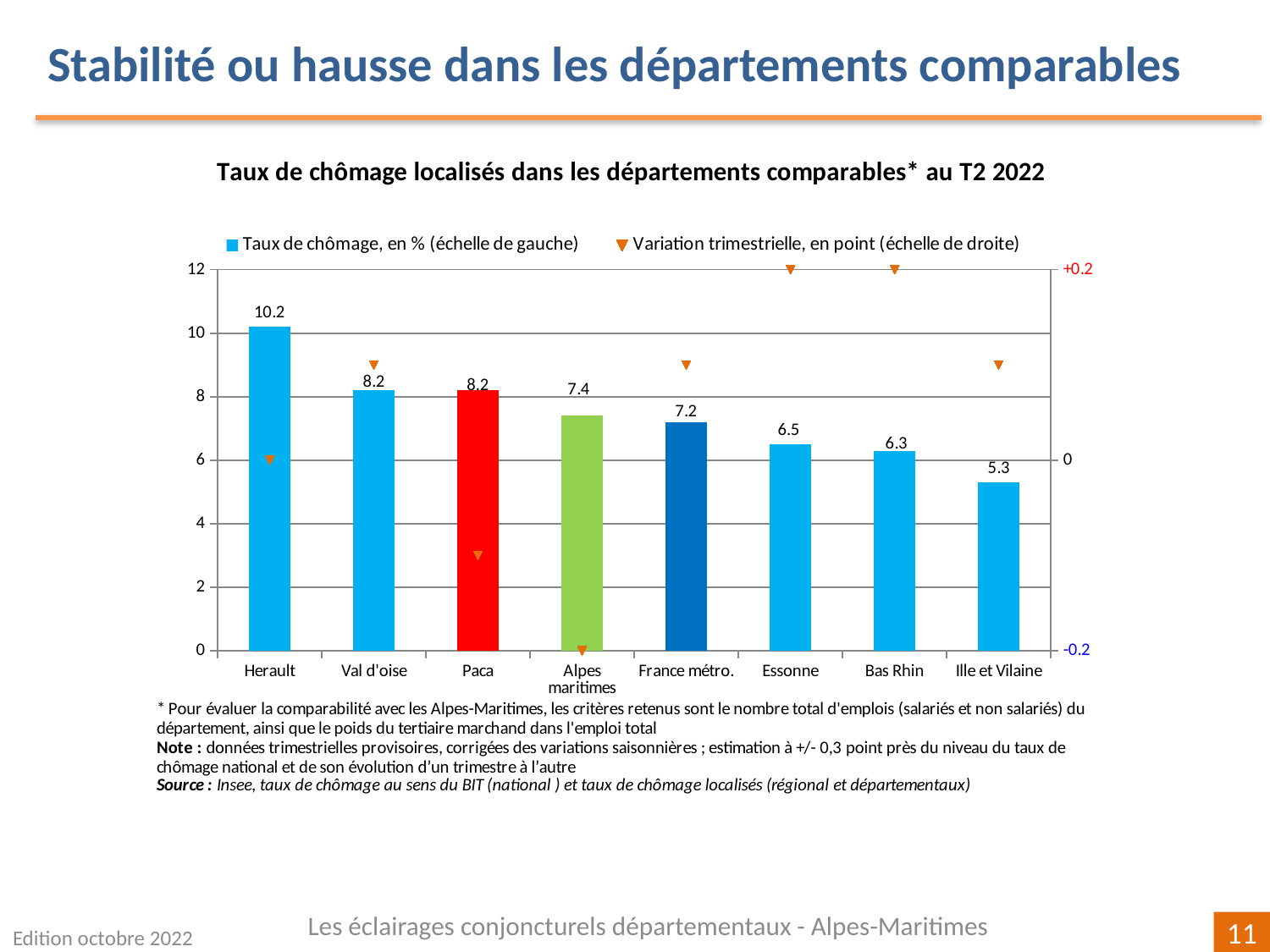
Which has a higher unemployment rate, Essonne or Bas Rhin? Essonne How many series does the legend list? 2 How many categories are shown on the x axis? 8 What is the unemployment rate (Taux de chômage) for Herault? 10.2 Which category has the highest unemployment rate? Herault Is the quarterly variation (Variation trimestrielle) for Val d'oise greater or less than 0? greater What is the unemployment rate shown for France métro.? 7.2 What is the difference between the unemployment rates of Herault and Ille et Vilaine? 4.9 Is the quarterly variation (Variation trimestrielle) for Paca greater or less than 0? less Which bar is coloured red? Paca Which category has the lowest unemployment rate? Ille et Vilaine What is the unemployment rate shown for Alpes maritimes? 7.4